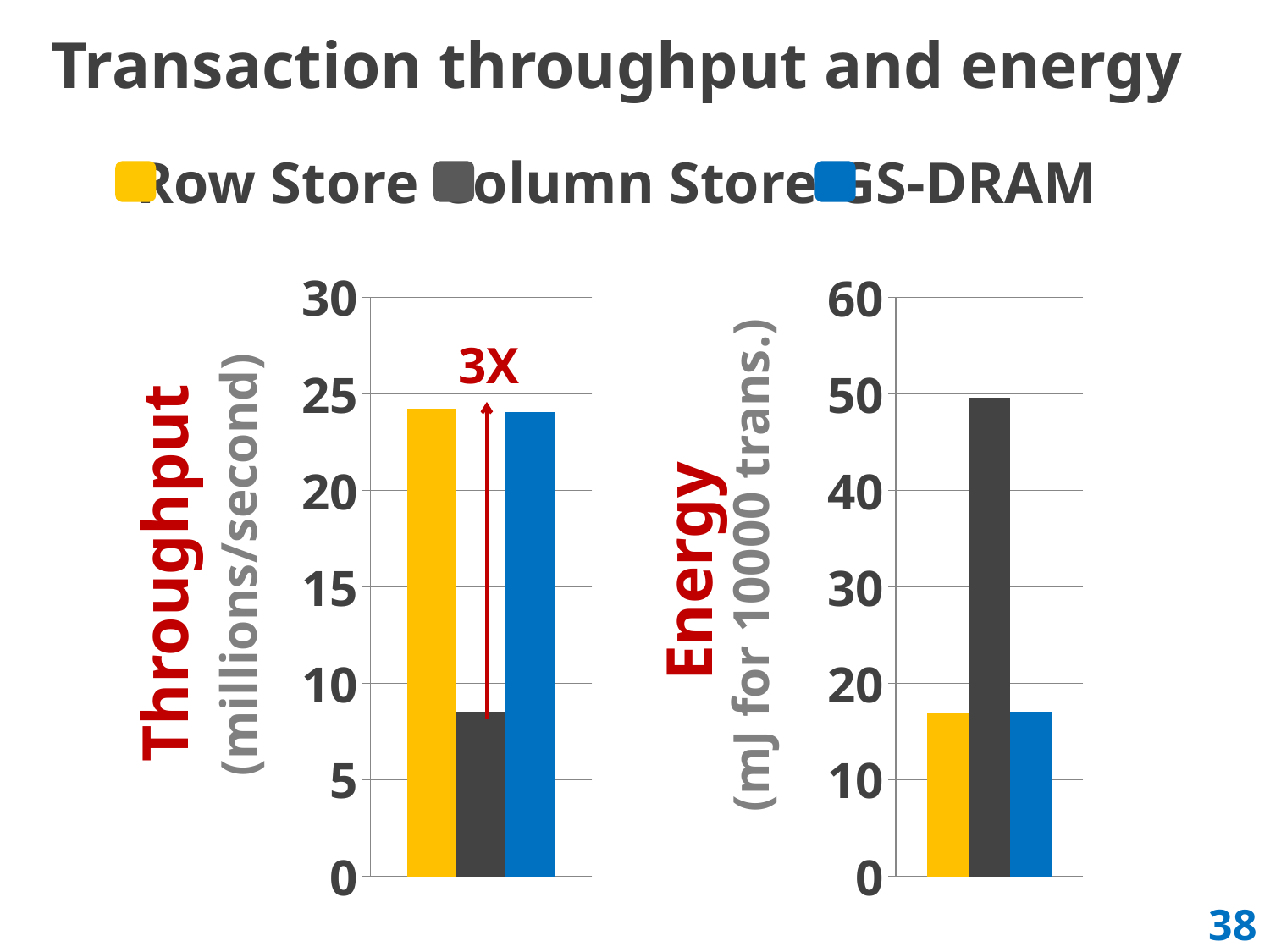
What kind of chart is the Throughput chart on the left? bar chart In the Energy chart, which series has the highest value? Column Store In the Energy chart, which is larger, the value for Column Store or the value for GS-DRAM? Column Store What unit is shown on the y axis of the Energy chart? mJ for 10000 trans. How many series does the legend list? 3 In the Throughput chart, which series has the lowest value? Column Store In the Throughput chart, is the value for Column Store greater or less than 10? less In the Throughput chart, is the value for GS-DRAM greater or less than 20? greater In the Throughput chart, which is larger, the value for Row Store or the value for Column Store? Row Store What annotation is written above the arrow in the Throughput chart? 3X In the Energy chart, is the value for Column Store greater or less than 40? greater